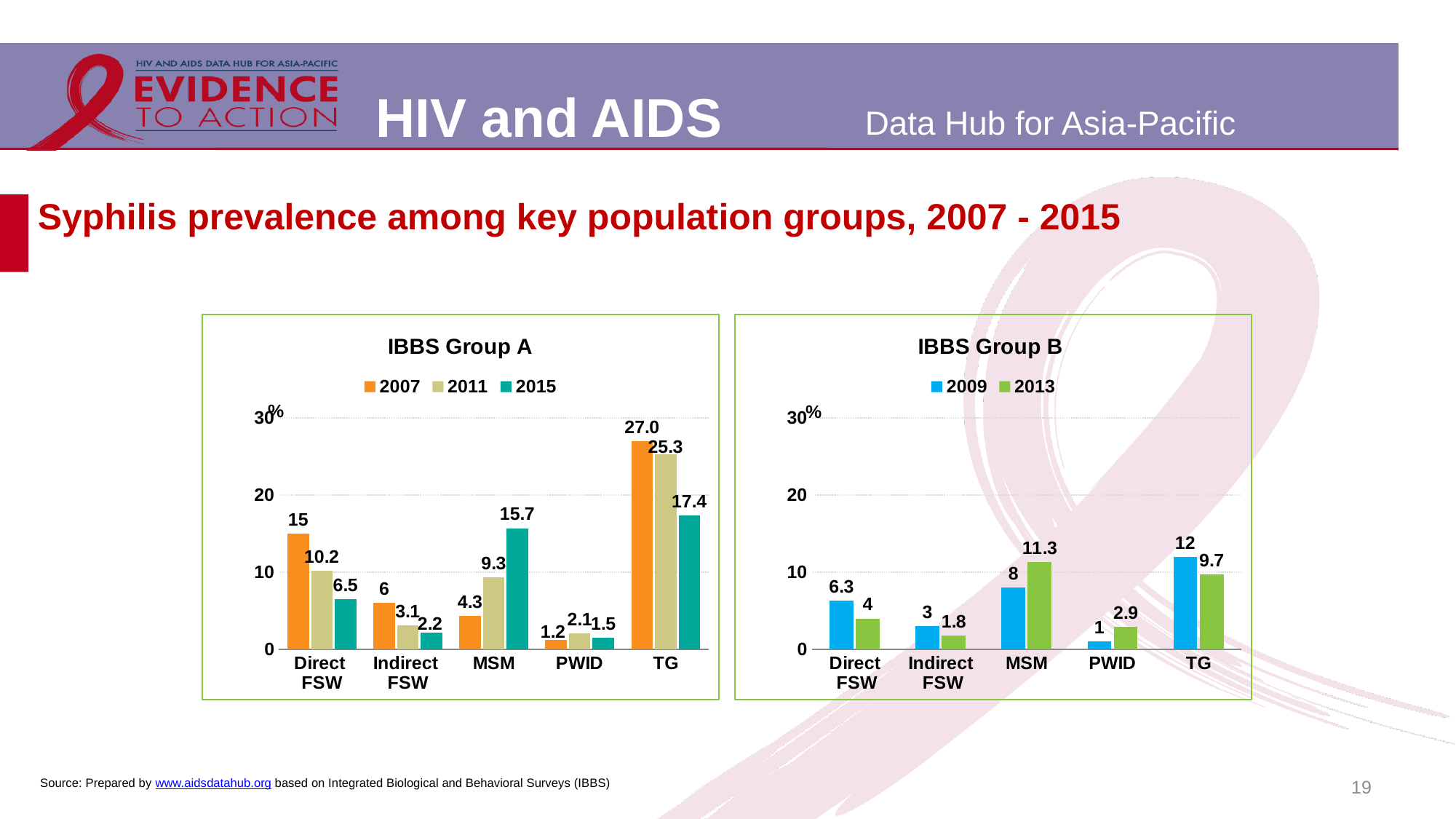
What kind of chart is the IBBS Group B chart? Bar chart In the IBBS Group A chart, what is the value for TG in 2007? 27.0 How many series does the legend of the IBBS Group A chart list? 3 In the IBBS Group A chart, what is the difference between the 2007 and 2015 values for TG? 9.6 In the IBBS Group B chart, what is the difference between the 2009 and 2013 values for MSM? 3.3 In the IBBS Group B chart, which is larger for TG: the 2009 value or the 2013 value? 2009 In the IBBS Group A chart, which population group has the lowest value in 2007? PWID In the IBBS Group B chart, which population group has the highest value in 2013? MSM In the IBBS Group A chart, do the values for Direct FSW rise or fall from 2007 to 2015? Fall How many population groups are shown on the x axis of the IBBS Group B chart? 5 In the IBBS Group B chart, what is the value for Direct FSW in 2009? 6.3 In the IBBS Group A chart, what is the value for MSM in 2015? 15.7